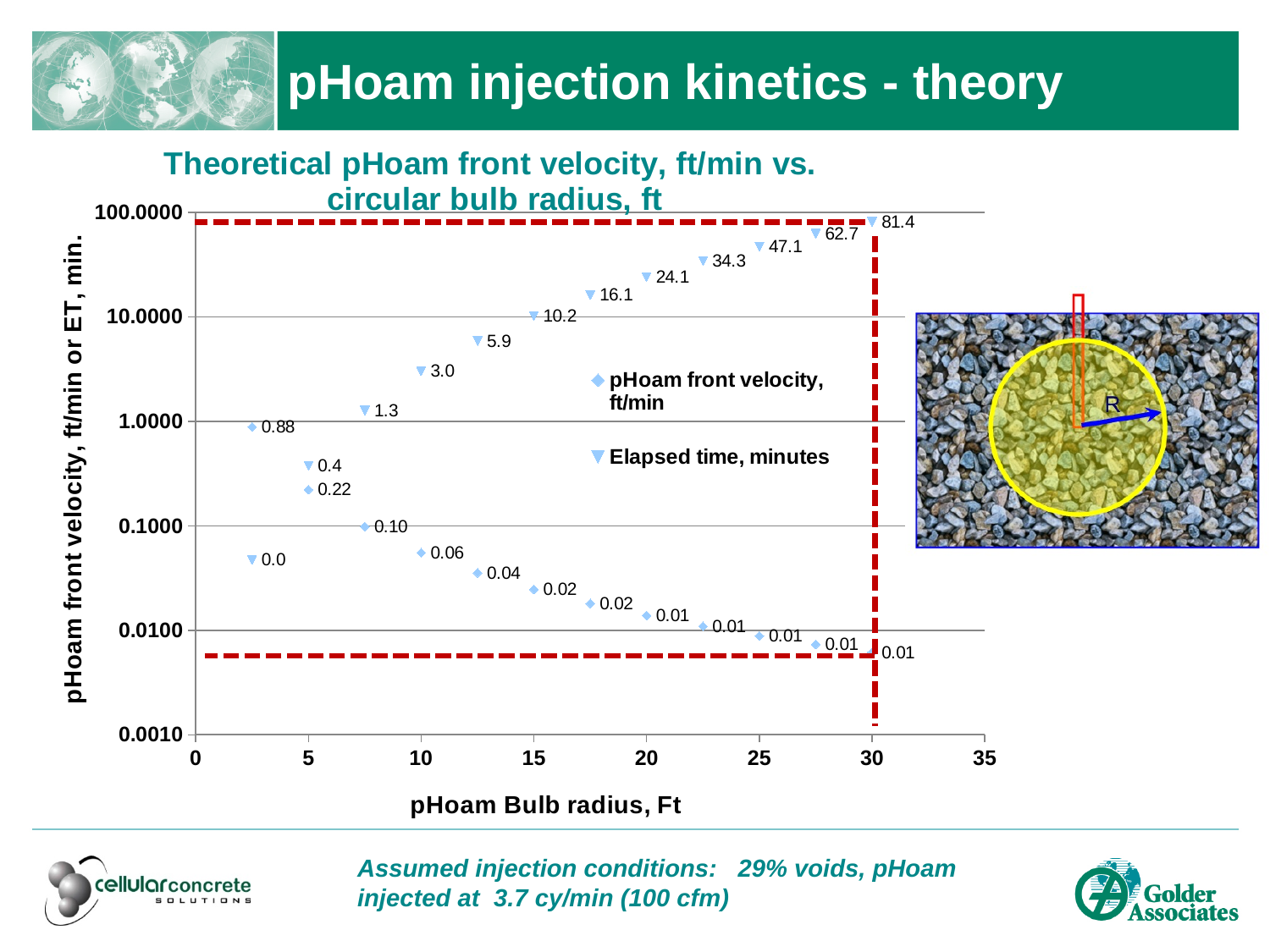
Which is larger: the elapsed time at a bulb radius of 20 ft or at 25 ft? 25 ft What is the chart title? Theoretical pHoam front velocity, ft/min vs. circular bulb radius, ft What is the difference in elapsed time between a bulb radius of 30 ft and 27.5 ft? 18.7 What is the elapsed time, in minutes, at a bulb radius of 30 ft? 81.4 How does the elapsed time change as the bulb radius increases along the x axis? It rises How many data points are plotted for the Elapsed time series? 12 What is the pHoam front velocity, in ft/min, at a bulb radius of 10 ft? 0.06 At which bulb radius is the pHoam front velocity highest? 2.5 What is the elapsed time, in minutes, at a bulb radius of 15 ft? 10.2 What kind of chart is shown on the slide? scatter chart At which bulb radius is the elapsed time highest? 30 How many series does the legend list? 2